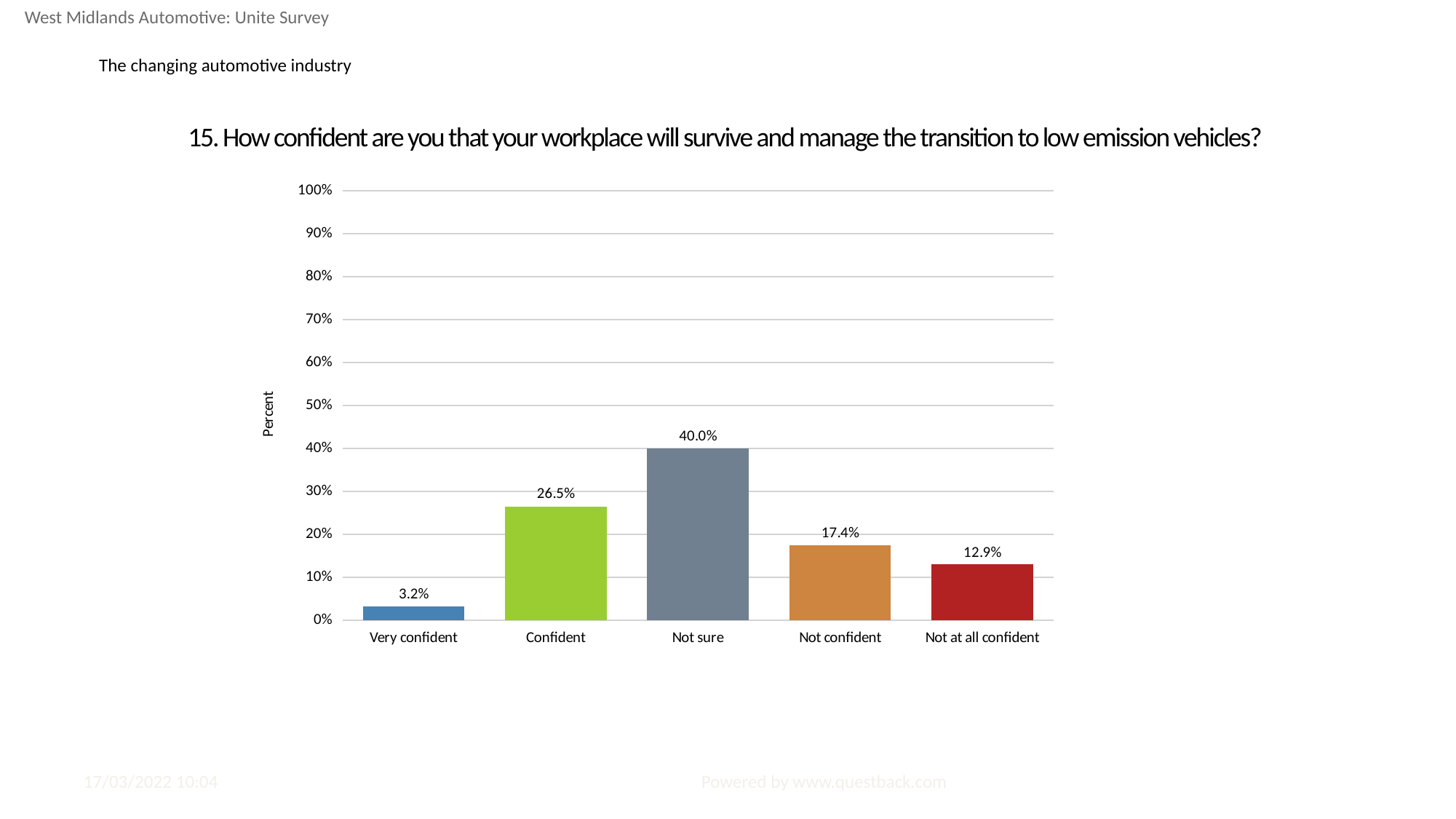
Which response category has the lowest value? Very confident Is the value for 'Confident' greater or less than 30%? less What is the difference between the 'Not sure' and 'Confident' values? 13.5% How many response categories are shown on the x axis? 5 What is the value for 'Very confident'? 3.2% What percentage of respondents answered 'Not sure'? 40.0% Which is larger, the value for 'Confident' or the value for 'Not confident'? Confident Which response category has the highest value? Not sure What kind of chart is shown on the slide? Bar chart What is the label on the vertical axis? Percent What percentage of respondents answered 'Not at all confident'? 12.9% What is the difference between the 'Not confident' and 'Not at all confident' values? 4.5%